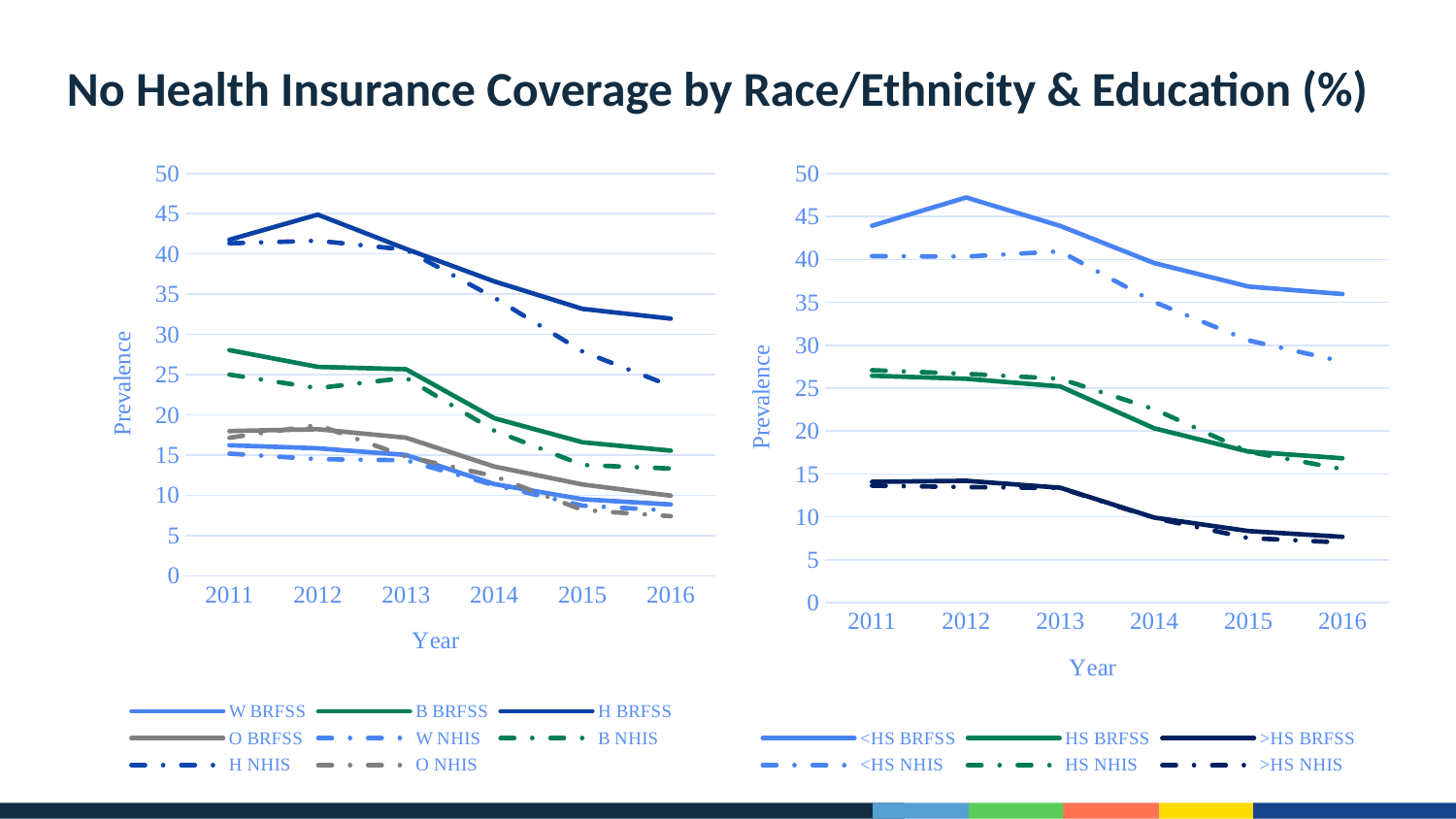
How many years are plotted along the x axis of the right chart? 6 In the right chart, which series has the highest value in 2011? <HS BRFSS In the left chart, is the value for H BRFSS in 2012 greater or less than 40? greater How many series does the legend of the left chart (race/ethnicity) list? 8 In the right chart, is the value for <HS BRFSS in 2012 greater or less than 40? greater In the left chart, which is larger in 2016: H BRFSS or B BRFSS? H BRFSS What is the label on the y axis of the left chart? Prevalence In the right chart, is the value for >HS BRFSS in 2016 greater or less than 10? less How many series does the legend of the right chart (education) list? 6 In the left chart, which series has the highest value in 2012? H BRFSS What kind of chart is the left chart on the slide? line chart In the left chart, does the H BRFSS line rise or fall from 2012 to 2016? fall